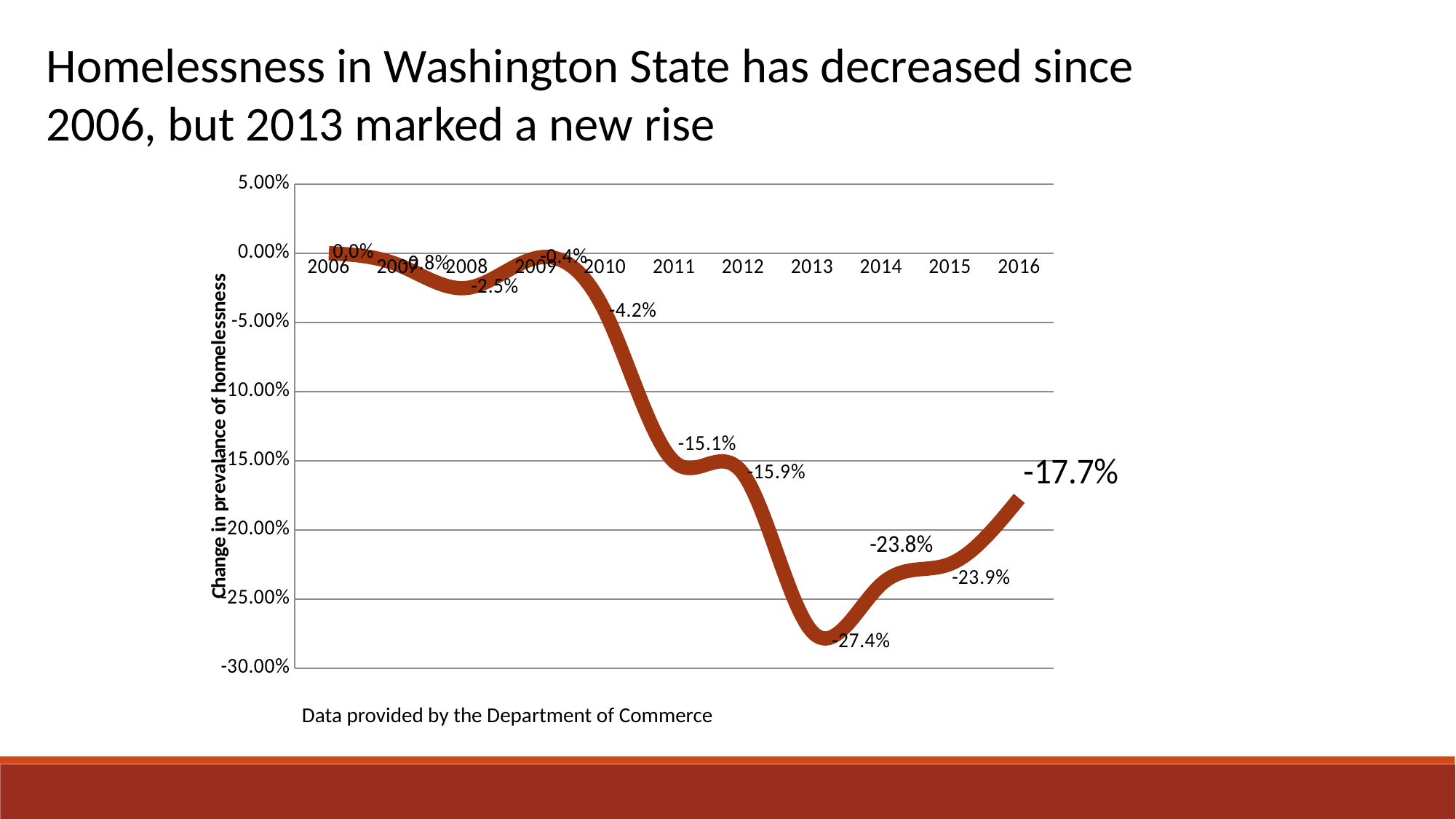
How many years are plotted on the x axis? 11 Does the value rise or fall from 2013 to 2016? rise What is the change in prevalence of homelessness for 2010? -4.2% What is the difference between the values for 2013 and 2016? 9.7 percentage points Which year has the highest value on the chart? 2006 Which year has the lowest value on the chart? 2013 What type of chart is shown on the slide? line chart What is the change in prevalence of homelessness for 2013? -27.4% Which year has the larger value, 2012 or 2014? 2012 What is the label of the vertical axis? Change in prevalance of homelessness What is the change in prevalence of homelessness for 2011? -15.1% What is the change in prevalence of homelessness for 2016? -17.7%